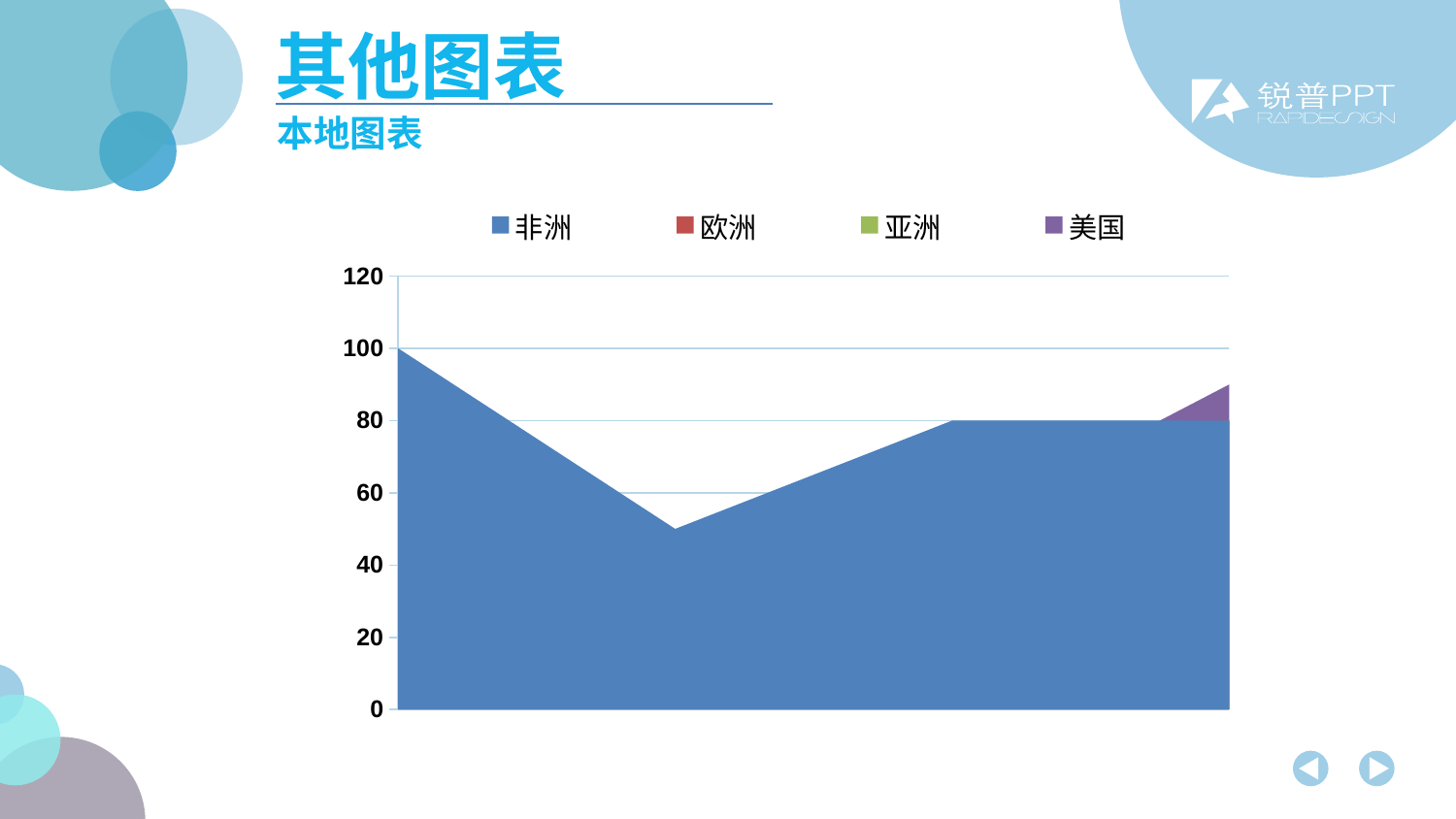
Which series are listed in the chart legend? 非洲, 欧洲, 亚洲, 美国 Which series appears only at the right end of the chart, above the 非洲 area? 美国 Is the lowest point of the 非洲 series greater or less than 40? greater Is the lowest point of the 非洲 series greater or less than 60? less What is the value of the 非洲 series at the rightmost point of the chart? 80 What colour represents the 非洲 series in the chart? blue What kind of chart is shown on the slide? area chart Which series occupies the largest area in the chart? 非洲 Is the highest point of the 非洲 series greater or less than 80? greater What is the value of the 非洲 series at the leftmost point of the chart? 100 How does the 非洲 series change from left to right across the chart? falls, then rises and levels off How many series does the chart legend list? 4